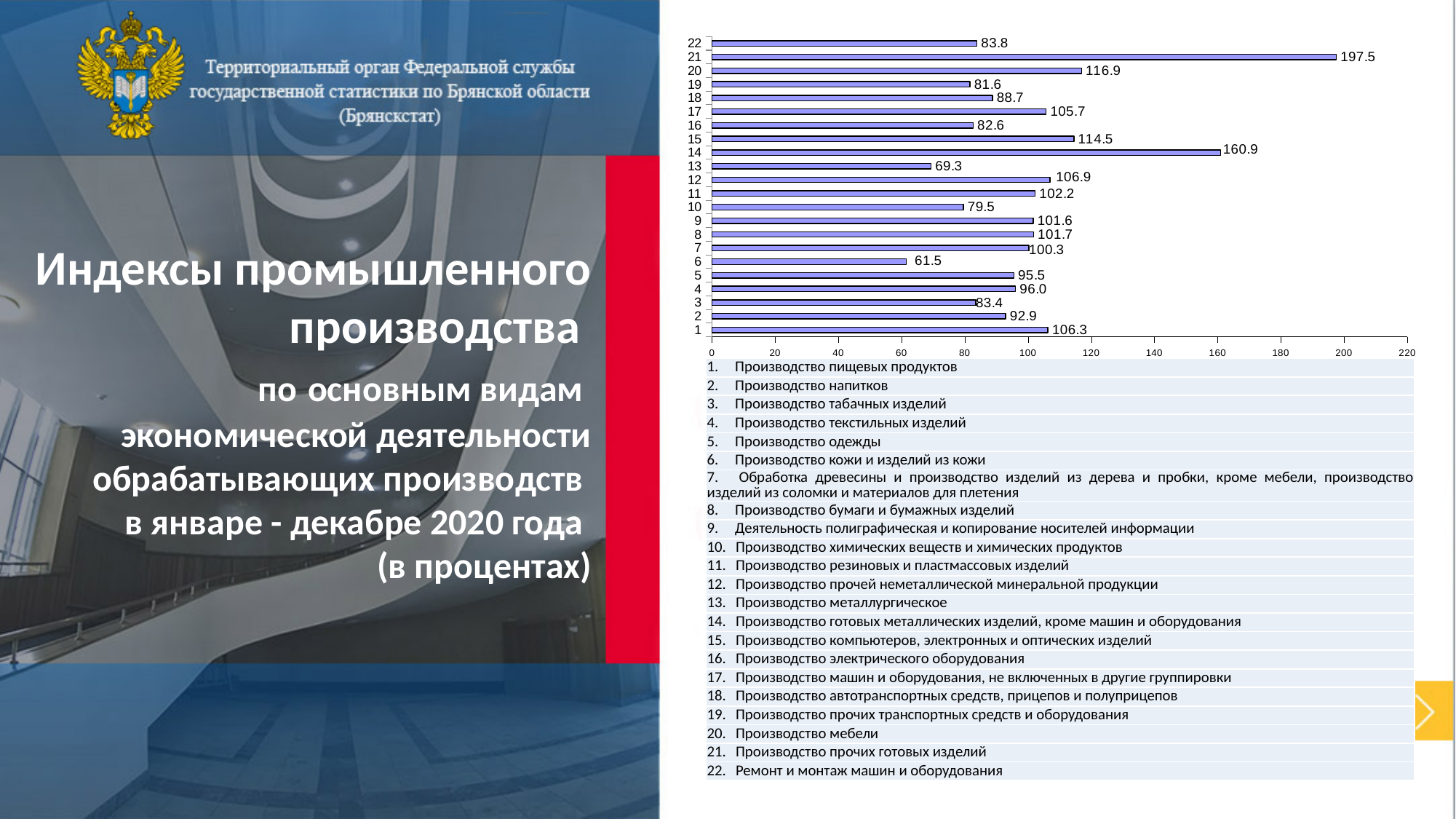
What is the difference between the values for category 21 and category 14? 36.6 What is the difference between the values for category 20 and category 19? 35.3 Which category has the lowest value? 6 (Производство кожи и изделий из кожи) What is the value for category 14 (Производство готовых металлических изделий, кроме машин и оборудования)? 160.9 Which category has the highest value? 21 (Производство прочих готовых изделий) What is the value for category 21 (Производство прочих готовых изделий)? 197.5 What is the value for category 6 (Производство кожи и изделий из кожи)? 61.5 What is the title of the slide containing the chart? Индексы промышленного производства по основным видам экономической деятельности обрабатывающих производств в январе - декабре 2020 года (в процентах) What type of chart is shown on the slide? bar chart What is the value for category 1 (Производство пищевых продуктов)? 106.3 How many categories (bars) does the chart show? 22 Which has a larger value, category 13 (Производство металлургическое) or category 10 (Производство химических веществ и химических продуктов)? category 10